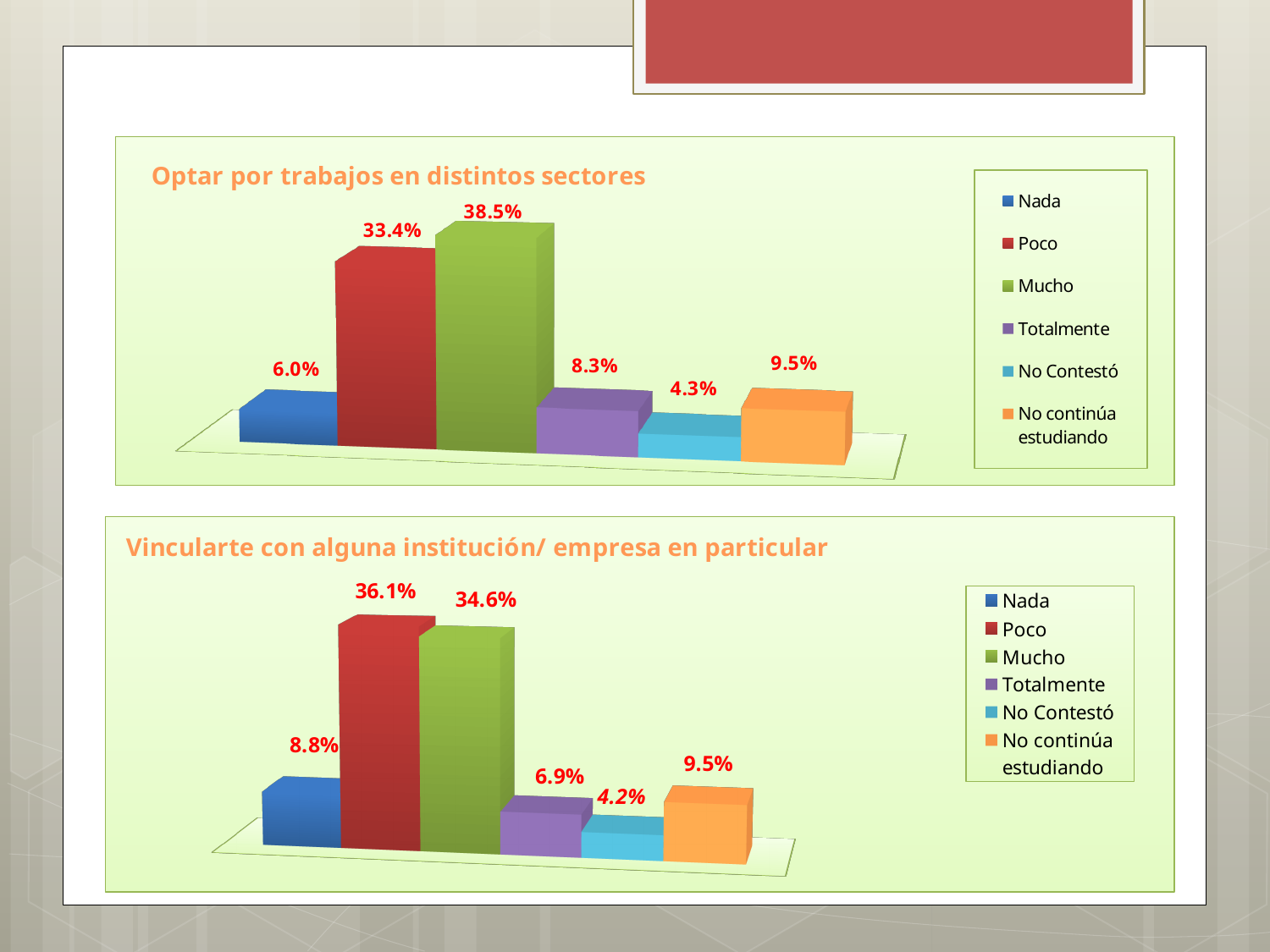
In the chart titled 'Vincularte con alguna institución/ empresa en particular', what is the difference between the values for Poco and Mucho? 1.5% What kind of chart is the chart titled 'Vincularte con alguna institución/ empresa en particular'? Bar chart In the chart titled 'Optar por trabajos en distintos sectores', what is the difference between the values for Mucho and Poco? 5.1% In the chart titled 'Vincularte con alguna institución/ empresa en particular', which category has the highest value? Poco In the chart titled 'Optar por trabajos en distintos sectores', what is the value for Mucho? 38.5% In the chart titled 'Optar por trabajos en distintos sectores', which category has the lowest value? No Contestó In the chart titled 'Optar por trabajos en distintos sectores', what is the value for No Contestó? 4.3% In the chart titled 'Vincularte con alguna institución/ empresa en particular', what is the value for Totalmente? 6.9% In the chart titled 'Vincularte con alguna institución/ empresa en particular', which is larger, the value for Nada or the value for No continúa estudiando? No continúa estudiando In the chart titled 'Vincularte con alguna institución/ empresa en particular', what is the value for Nada? 8.8% How many entries does the legend list in the chart titled 'Optar por trabajos en distintos sectores'? 6 In the chart titled 'Optar por trabajos en distintos sectores', which category has the highest value? Mucho